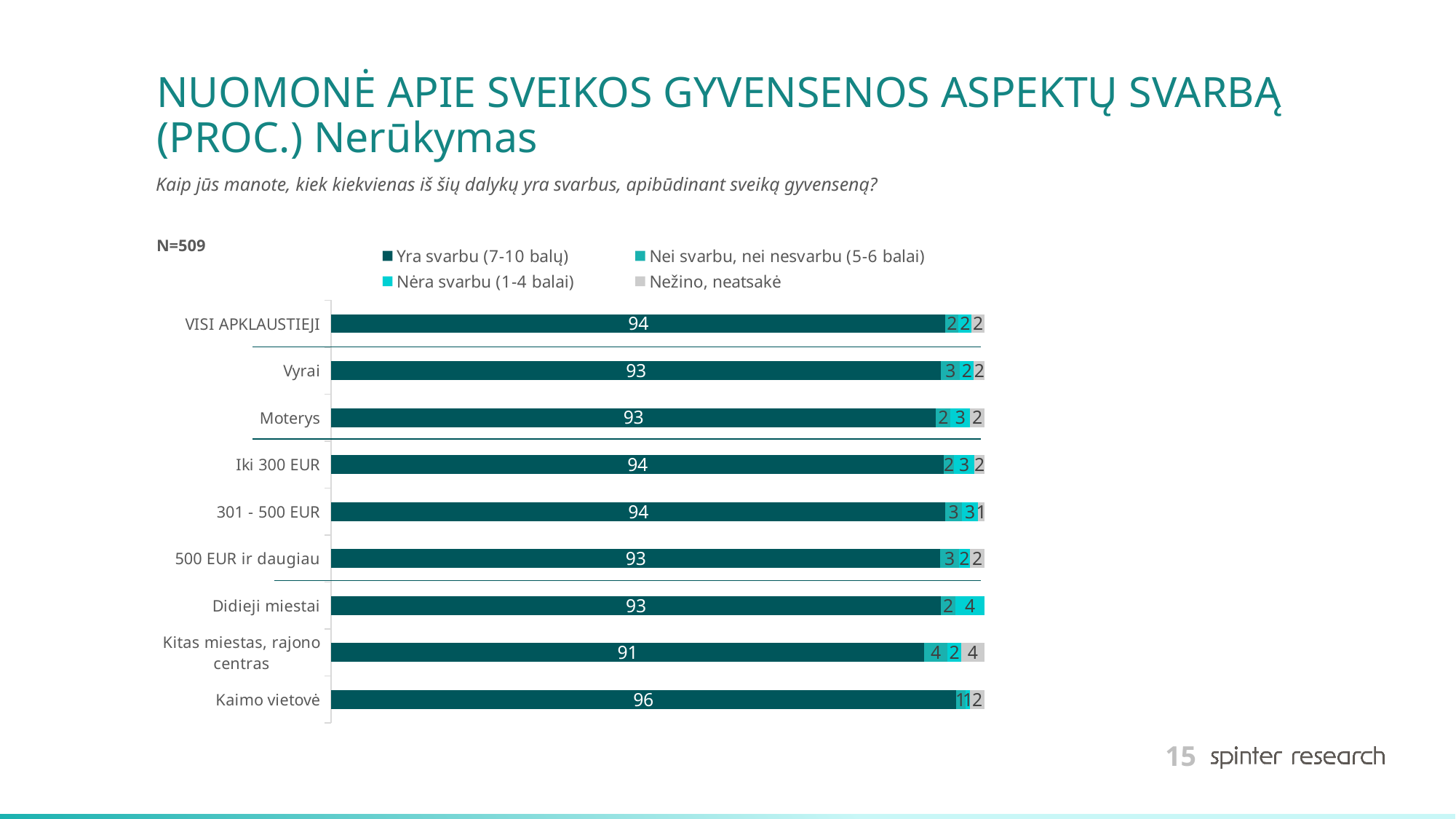
How many series does the legend list? 4 What is the difference between the "Yra svarbu (7-10 balų)" values for Kaimo vietovė and Kitas miestas, rajono centras? 5 Which category has the lowest "Yra svarbu (7-10 balų)" value? Kitas miestas, rajono centras What is the value of "Yra svarbu (7-10 balų)" for Kitas miestas, rajono centras? 91 Which category has the highest "Yra svarbu (7-10 balų)" value? Kaimo vietovė Which has a larger "Yra svarbu (7-10 balų)" value, Vyrai or Iki 300 EUR? Iki 300 EUR What is the value of "Nežino, neatsakė" for Kitas miestas, rajono centras? 4 What is the value of "Yra svarbu (7-10 balų)" for VISI APKLAUSTIEJI? 94 What kind of chart is shown on the slide? Stacked bar chart What sample size (N) is stated on the slide? N=509 How many categories are shown on the chart? 9 What is the value of "Yra svarbu (7-10 balų)" for Kaimo vietovė? 96